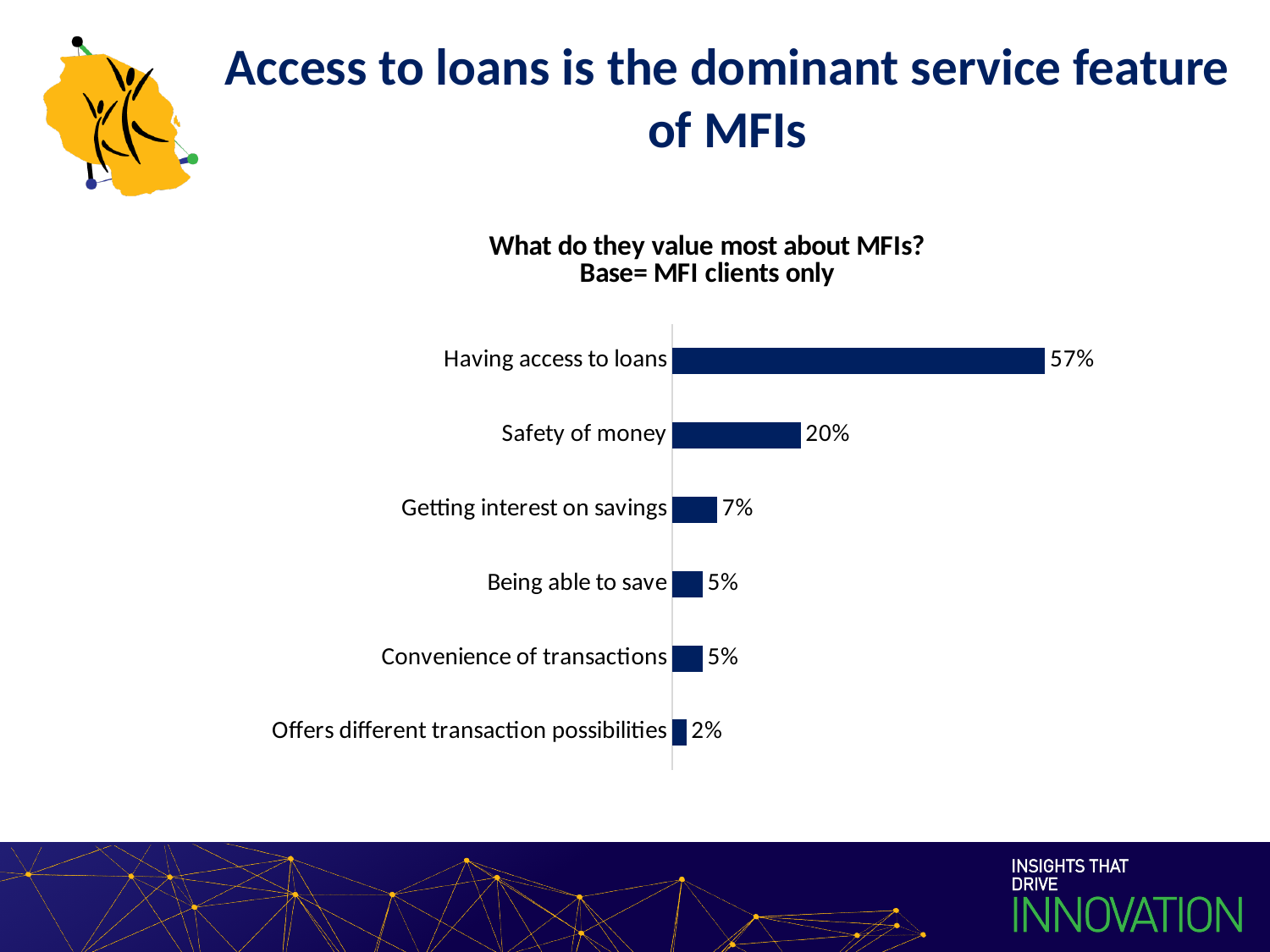
Which is larger, the value for Safety of money or the value for Getting interest on savings? Safety of money What is the value for Getting interest on savings? 7% What percentage of MFI clients value having access to loans most? 57% What kind of chart is shown on the slide? Bar chart What is the value for Safety of money? 20% What is the title of the chart? What do they value most about MFIs? Base= MFI clients only What is the difference between the values for Being able to save and Offers different transaction possibilities? 3 percentage points What is the value for Offers different transaction possibilities? 2% How many categories are shown in the chart? 6 What is the difference between the values for Having access to loans and Safety of money? 37 percentage points Which category has the highest value? Having access to loans Which category has the lowest value? Offers different transaction possibilities